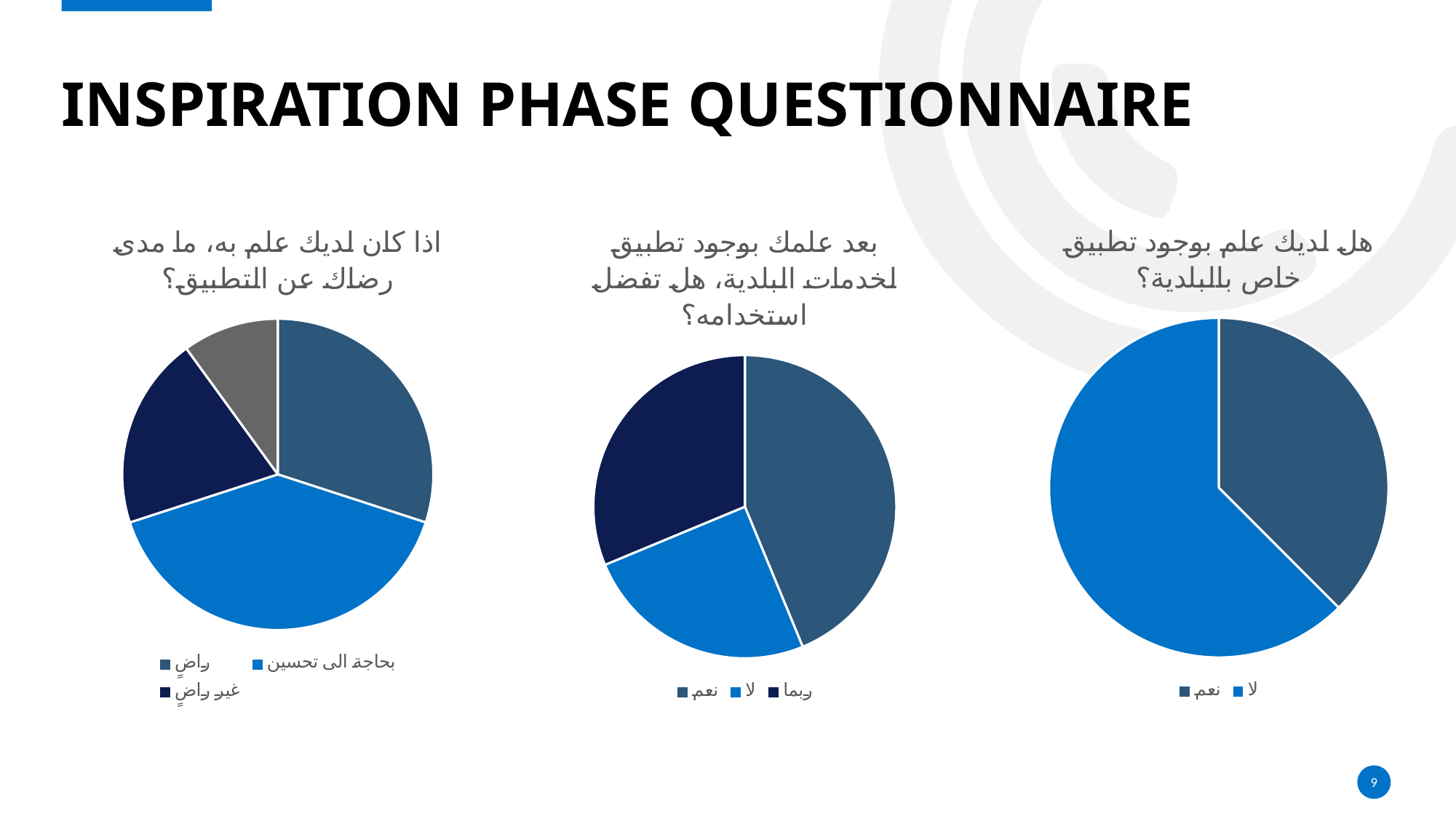
In the right pie chart ("هل لديك علم بوجود تطبيق خاص بالبلدية؟"), which slice is larger, نعم or لا? لا In the middle pie chart ("بعد علمك بوجود تطبيق لخدمات البلدية، هل تفضل استخدامه؟"), how many entries does the legend list? 3 In the right pie chart ("هل لديك علم بوجود تطبيق خاص بالبلدية؟"), which answer has the largest slice? لا What is the title of the slide? INSPIRATION PHASE QUESTIONNAIRE In the left pie chart ("اذا كان لديك علم به، ما مدى رضاك عن التطبيق؟"), how many slices does the pie have? 4 In the middle pie chart ("بعد علمك بوجود تطبيق لخدمات البلدية، هل تفضل استخدامه؟"), which answer has the largest slice? نعم In the right pie chart ("هل لديك علم بوجود تطبيق خاص بالبلدية؟"), how many entries does the legend list? 2 How many charts are shown on the slide? 3 In the middle pie chart ("بعد علمك بوجود تطبيق لخدمات البلدية، هل تفضل استخدامه؟"), which slice is larger, نعم or لا? نعم In the left pie chart ("اذا كان لديك علم به، ما مدى رضاك عن التطبيق؟"), which slice is larger, راضٍ or غير راضٍ? راضٍ What kind of chart is used for the question "هل لديك علم بوجود تطبيق خاص بالبلدية؟" on the right of the slide? Pie chart In the left pie chart ("اذا كان لديك علم به، ما مدى رضاك عن التطبيق؟"), how many entries does the legend list? 3